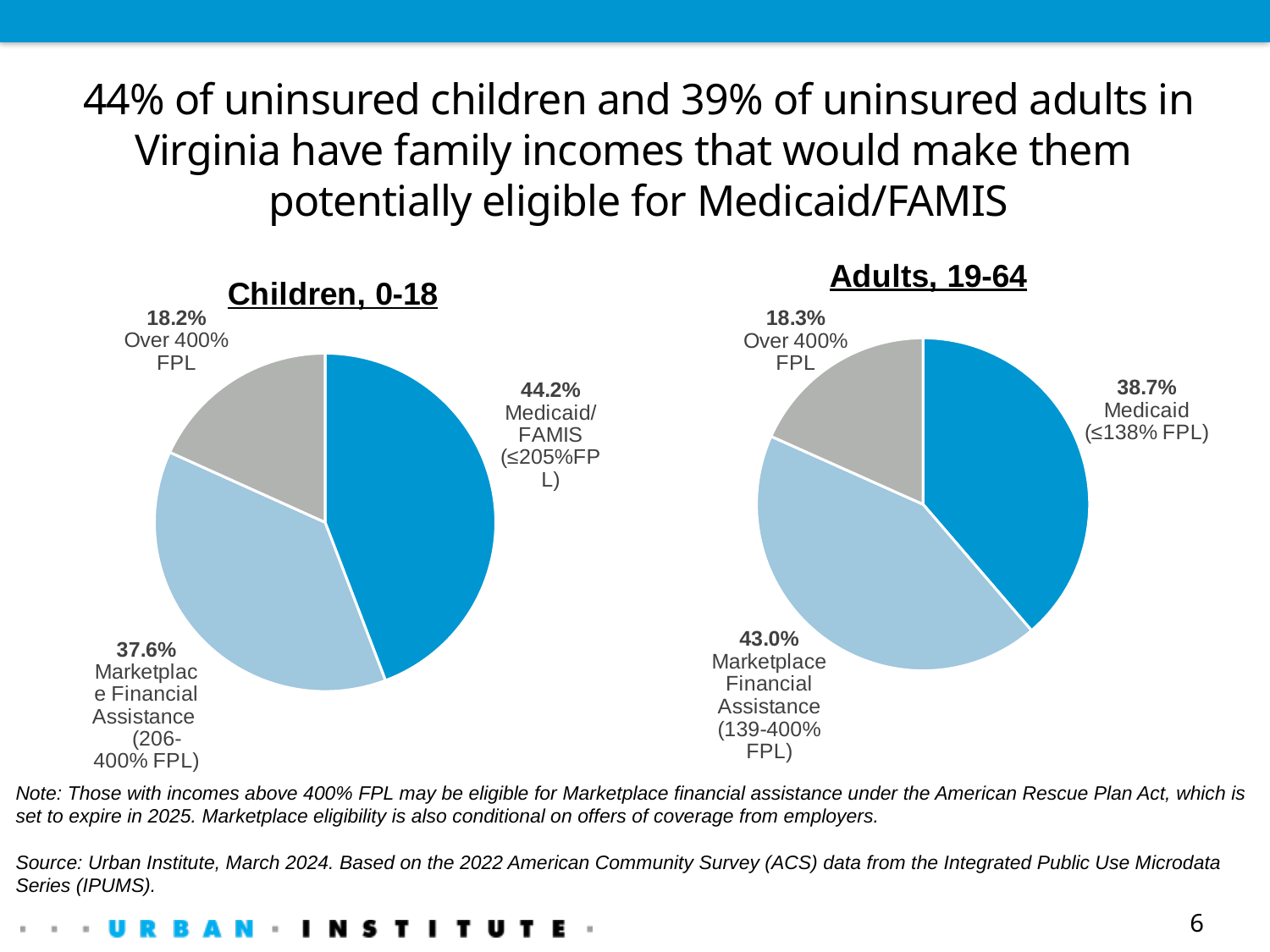
In the 'Adults, 19-64' chart, which category has the smallest share? Over 400% FPL How many categories does the 'Adults, 19-64' chart show? 3 In the 'Adults, 19-64' chart, which category has the largest share? Marketplace Financial Assistance (139-400% FPL) In the 'Children, 0-18' chart, which category has the largest share? Medicaid/FAMIS (≤205% FPL) In the 'Children, 0-18' chart, what share of uninsured children have incomes making them eligible for Medicaid/FAMIS (≤205% FPL)? 44.2% In the 'Children, 0-18' chart, what is the difference between the Medicaid/FAMIS share and the Marketplace Financial Assistance share? 6.6 percentage points What type of chart is used for the 'Children, 0-18' data? Pie chart In the 'Adults, 19-64' chart, what percentage of uninsured adults are in the Medicaid (≤138% FPL) category? 38.7% Which is larger: the Over 400% FPL share in the 'Children, 0-18' chart or the Over 400% FPL share in the 'Adults, 19-64' chart? Adults, 19-64 In the 'Adults, 19-64' chart, what percentage of uninsured adults fall in the Marketplace Financial Assistance (139-400% FPL) category? 43.0% What is the difference between the Medicaid/FAMIS share in the 'Children, 0-18' chart and the Medicaid share in the 'Adults, 19-64' chart? 5.5 percentage points In the 'Children, 0-18' chart, what percentage of uninsured children have incomes over 400% FPL? 18.2%